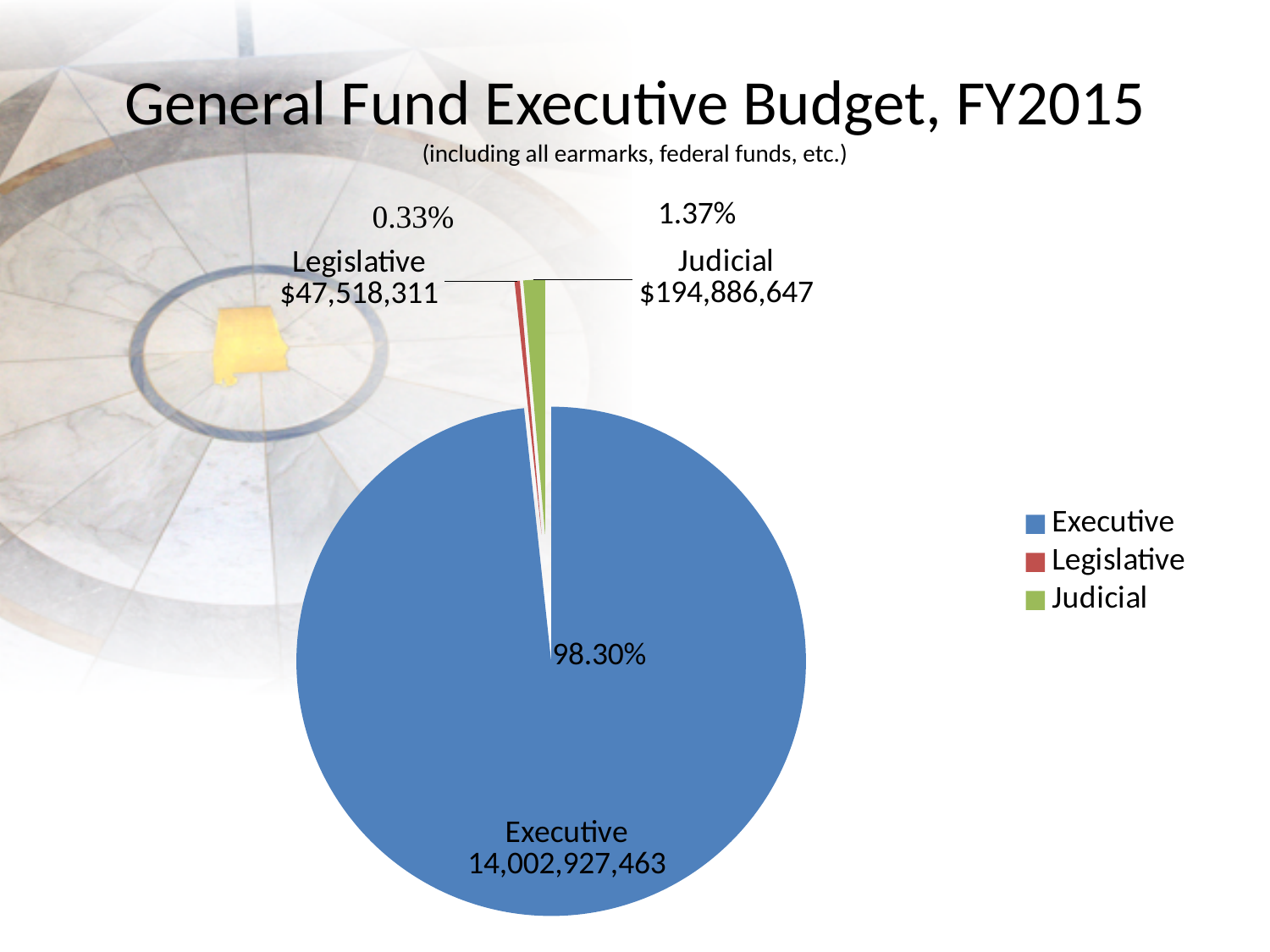
Which is larger, the Judicial slice or the Legislative slice? Judicial Which category has the largest slice of the pie? Executive What percentage share of the pie does the Judicial slice represent? 1.37% What kind of chart is shown on the slide? pie chart What is the value for the Legislative slice? $47,518,311 What is the value for the Executive slice? 14,002,927,463 What is the value for the Judicial slice? $194,886,647 What is the title of the chart on the slide? General Fund Executive Budget, FY2015 Which category has the smallest slice of the pie? Legislative What percentage share of the pie does the Legislative slice represent? 0.33% What percentage share of the pie does the Executive slice represent? 98.30% How many categories does the pie chart show? 3